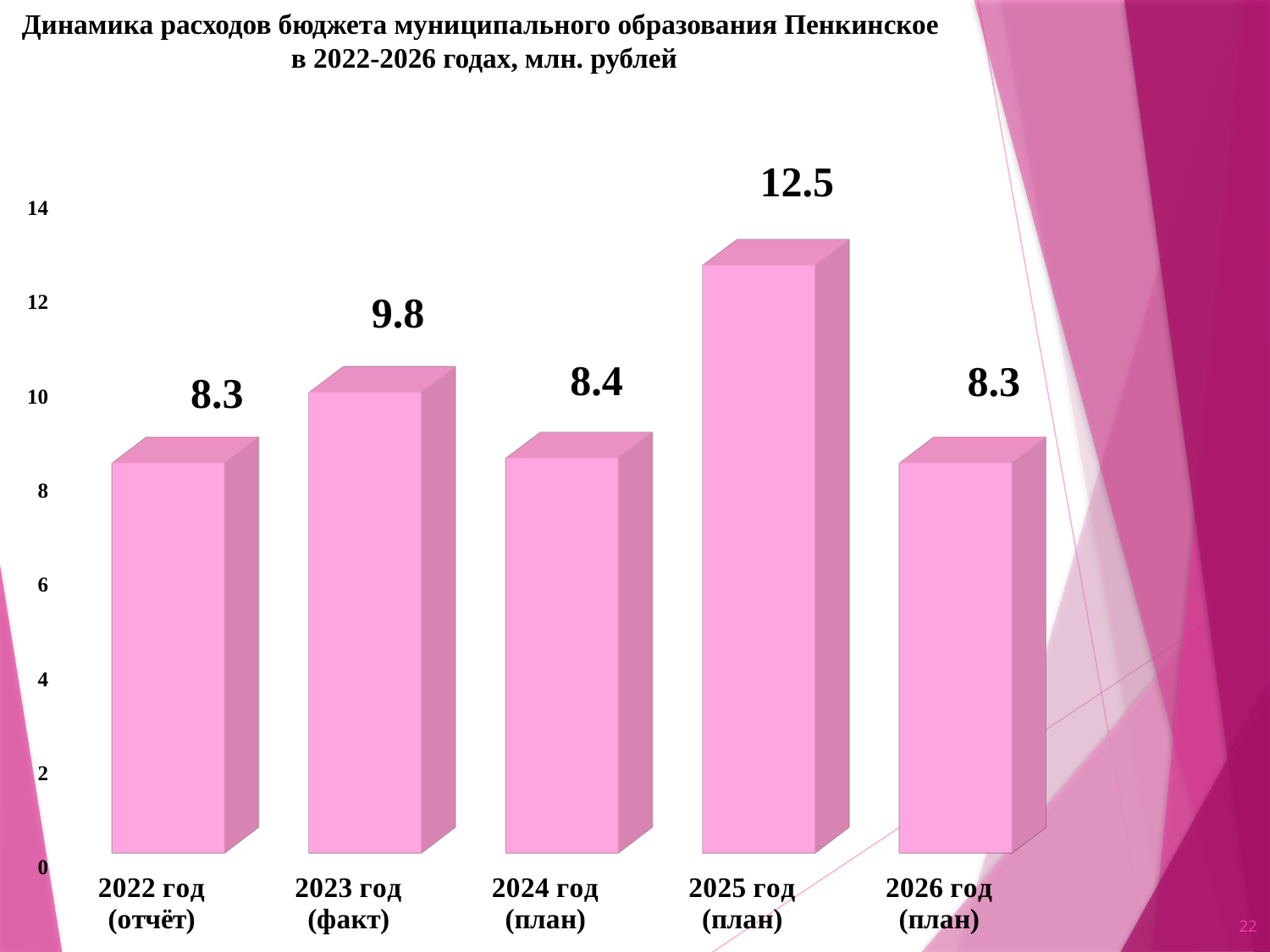
What is the value for 2024 год (план)? 8.4 What kind of chart is shown on the slide? bar chart How many years are shown on the chart? 5 What is the value for 2025 год (план)? 12.5 Which year has the highest value? 2025 год (план) What is the difference between the values for 2023 год (факт) and 2022 год (отчёт)? 1.5 Which is larger, the value for 2023 год (факт) or the value for 2024 год (план)? 2023 год (факт) Do the values rise or fall from 2025 год (план) to 2026 год (план)? fall What unit is stated in the chart title? млн. рублей What is the value for 2023 год (факт)? 9.8 Is the value for 2025 год (план) greater or less than 12? greater What is the difference between the values for 2025 год (план) and 2023 год (факт)? 2.7